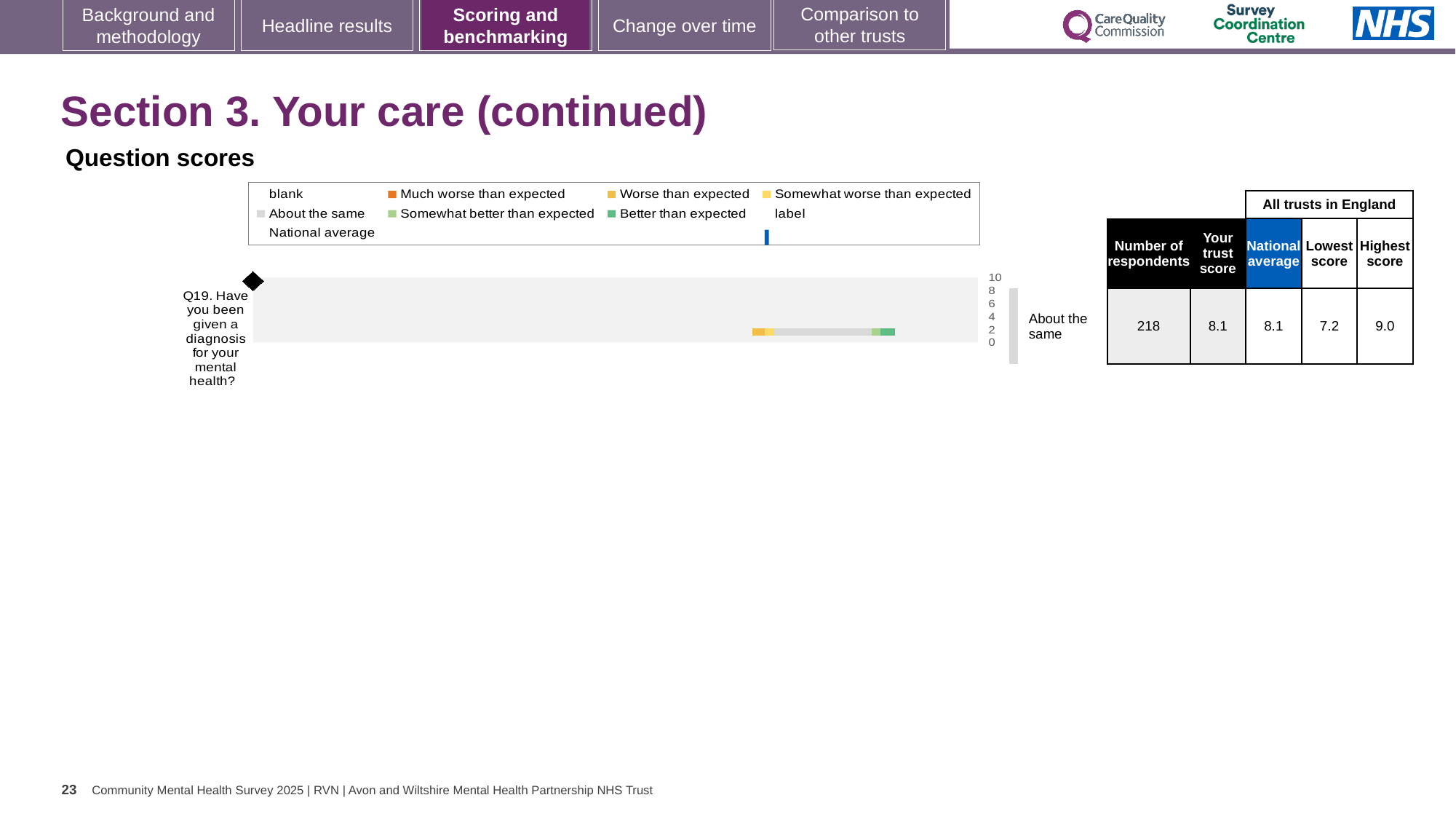
What is the national average score for Q19? 8.1 Is the trust score for Q19 greater or less than 6 on the chart's axis? greater What is the difference between the highest and lowest trust scores for Q19? 1.8 How many respondents answered Q19? 218 Which benchmark category is shown for Q19 in the question scores chart? About the same What is the lowest score among all trusts in England for Q19? 7.2 Which question is plotted in the question scores chart? Q19. Have you been given a diagnosis for your mental health? What is the maximum value shown on the score axis of the question scores chart? 10 What is the trust score for Q19? 8.1 How many questions are plotted in the question scores chart? 1 What is the highest score among all trusts in England for Q19? 9.0 What kind of chart is used to show the Q19 question score? bar chart